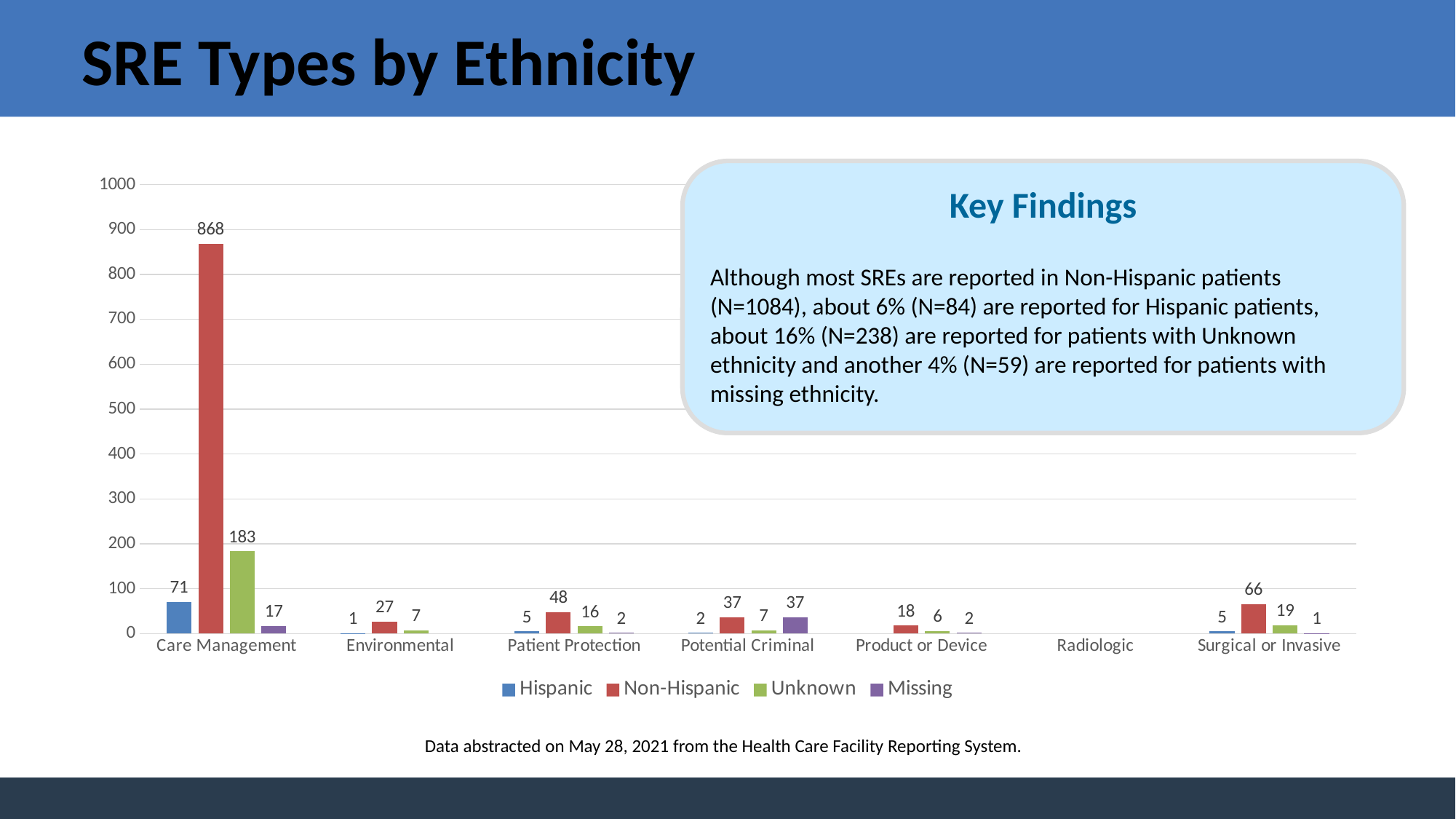
What kind of chart is shown on the slide? Bar chart Which category has the highest Non-Hispanic value? Care Management What is the Missing value for Potential Criminal? 37 How many series does the legend list? 4 Is the Non-Hispanic value for Care Management greater or less than 800? greater What is the Unknown value for Care Management? 183 Which is larger, the Non-Hispanic value for Patient Protection or the Non-Hispanic value for Potential Criminal? Patient Protection What is the Non-Hispanic value for Care Management? 868 What is the Non-Hispanic value for Surgical or Invasive? 66 What is the difference between the Non-Hispanic and Hispanic values for Care Management? 797 How many SRE type categories are shown on the x axis? 7 Which category has the lowest Hispanic value among those with a labelled Hispanic bar? Environmental